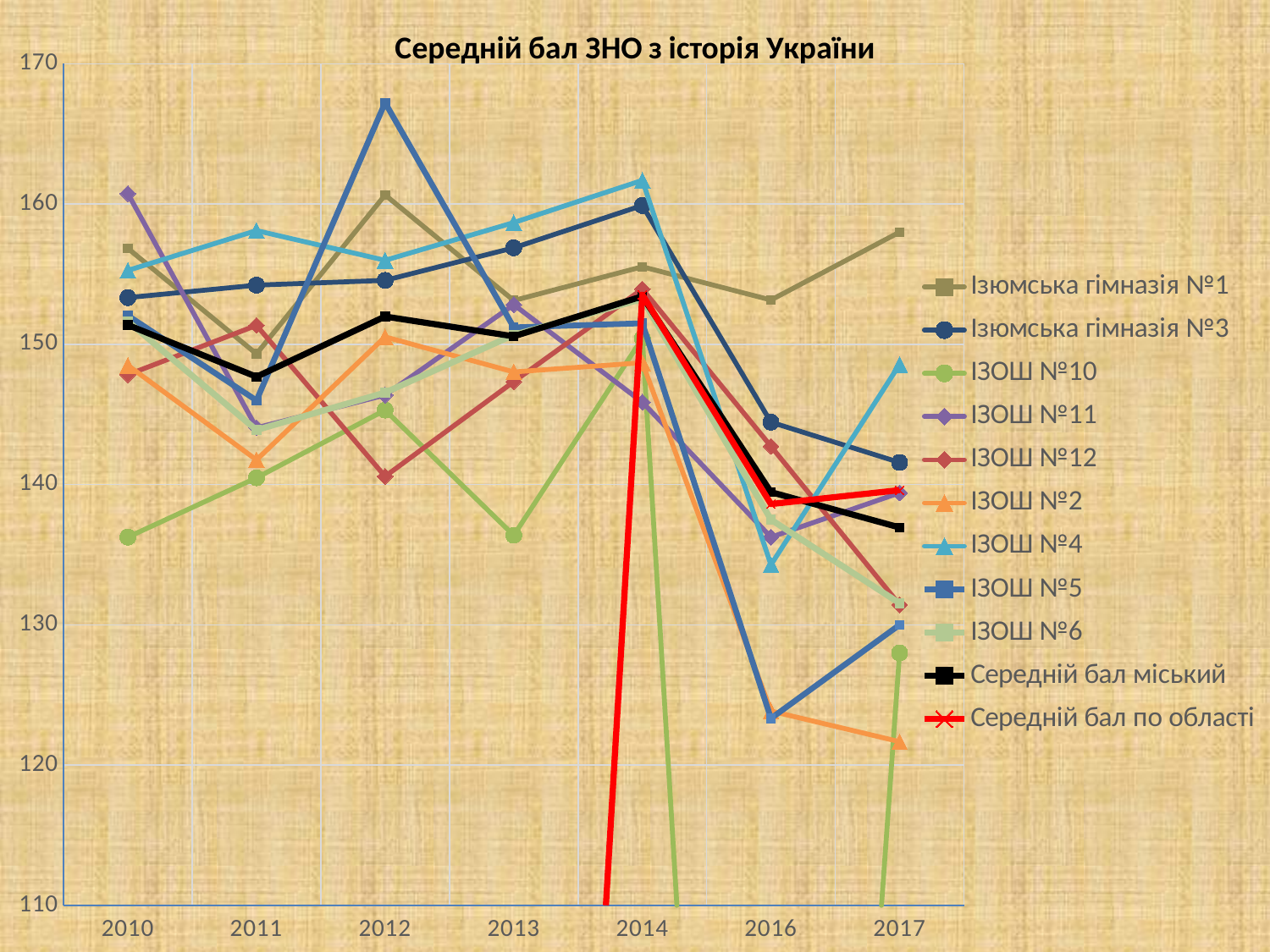
Which series has the lowest value in 2010? ІЗОШ №10 What is the title of the chart? Середній бал ЗНО з історія України Is the value for ІЗОШ №5 in 2012 greater or less than 160? greater Is the value for Середній бал міський in 2017 greater or less than 140? less How many years are shown on the x axis? 7 How many series does the legend list? 11 In 2013, which is larger: Ізюмська гімназія №3 or ІЗОШ №10? Ізюмська гімназія №3 Does the value for Середній бал по області rise or fall from 2014 to 2016? fall Which series has the lowest value in 2017? ІЗОШ №2 What kind of chart is shown on the slide? line chart Which series has the highest value in 2012? ІЗОШ №5 Is the value for ІЗОШ №10 in 2010 greater or less than 140? less